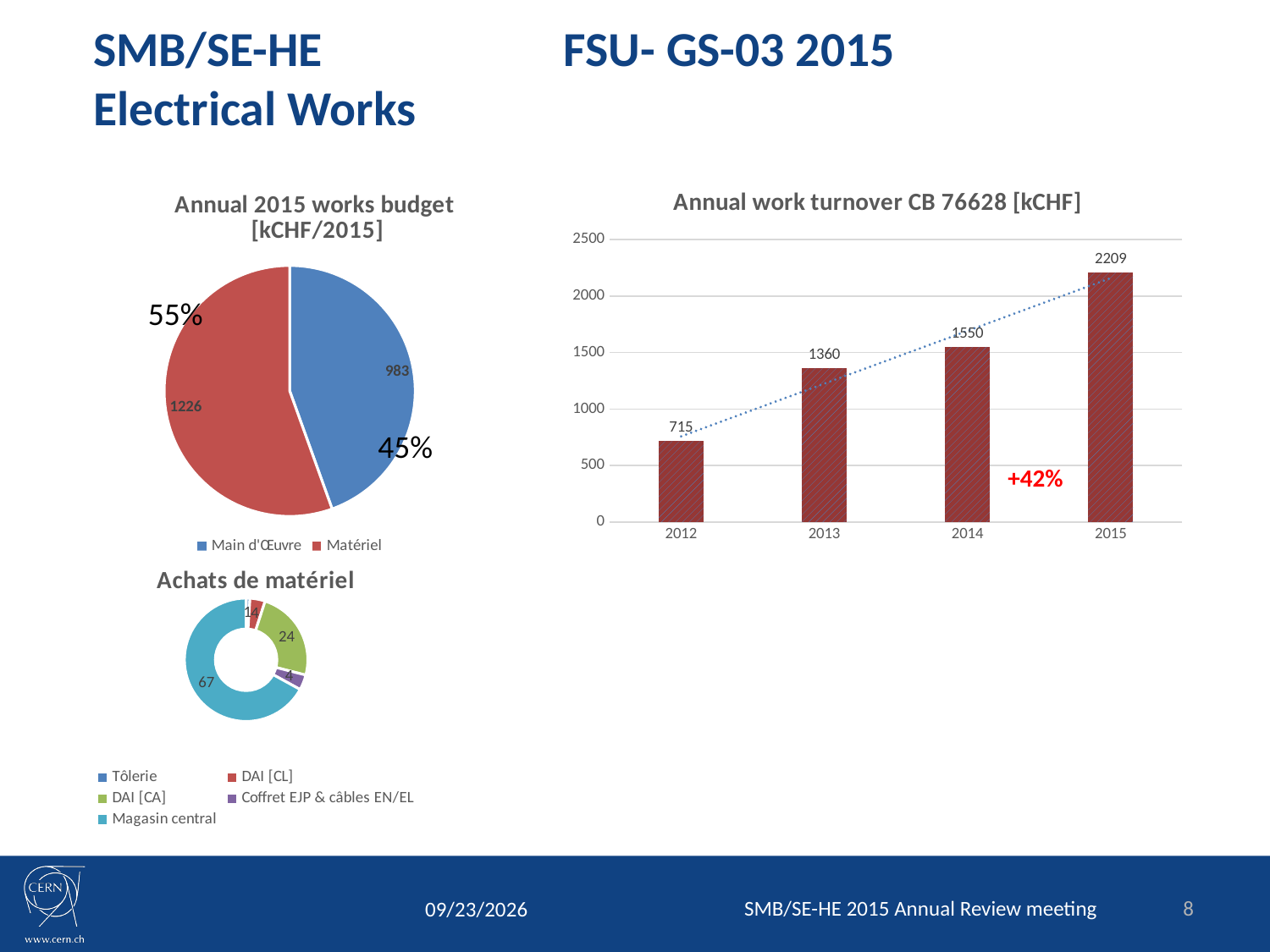
In the 'Annual work turnover CB 76628' bar chart, which year has the lowest value? 2012 In the 'Annual 2015 works budget' pie chart, what is the value for Main d'Œuvre? 983 How many entries does the legend of the 'Achats de matériel' chart list? 5 In the 'Annual 2015 works budget' pie chart, what percentage share does Matériel have? 55% In the 'Annual work turnover CB 76628' bar chart, what is the difference between the 2015 and 2014 values? 659 How many years are shown in the 'Annual work turnover CB 76628' bar chart? 4 In the 'Annual 2015 works budget' pie chart, what is the value for Matériel? 1226 In the 'Achats de matériel' doughnut chart, what is the value for Magasin central? 67 In the 'Annual work turnover CB 76628' bar chart, which year has the highest value? 2015 In the 'Annual work turnover CB 76628' bar chart, what is the value for 2013? 1360 In the 'Annual work turnover CB 76628' bar chart, do the values rise or fall from 2012 to 2015? rise In the 'Annual 2015 works budget' pie chart, which category is larger, Main d'Œuvre or Matériel? Matériel